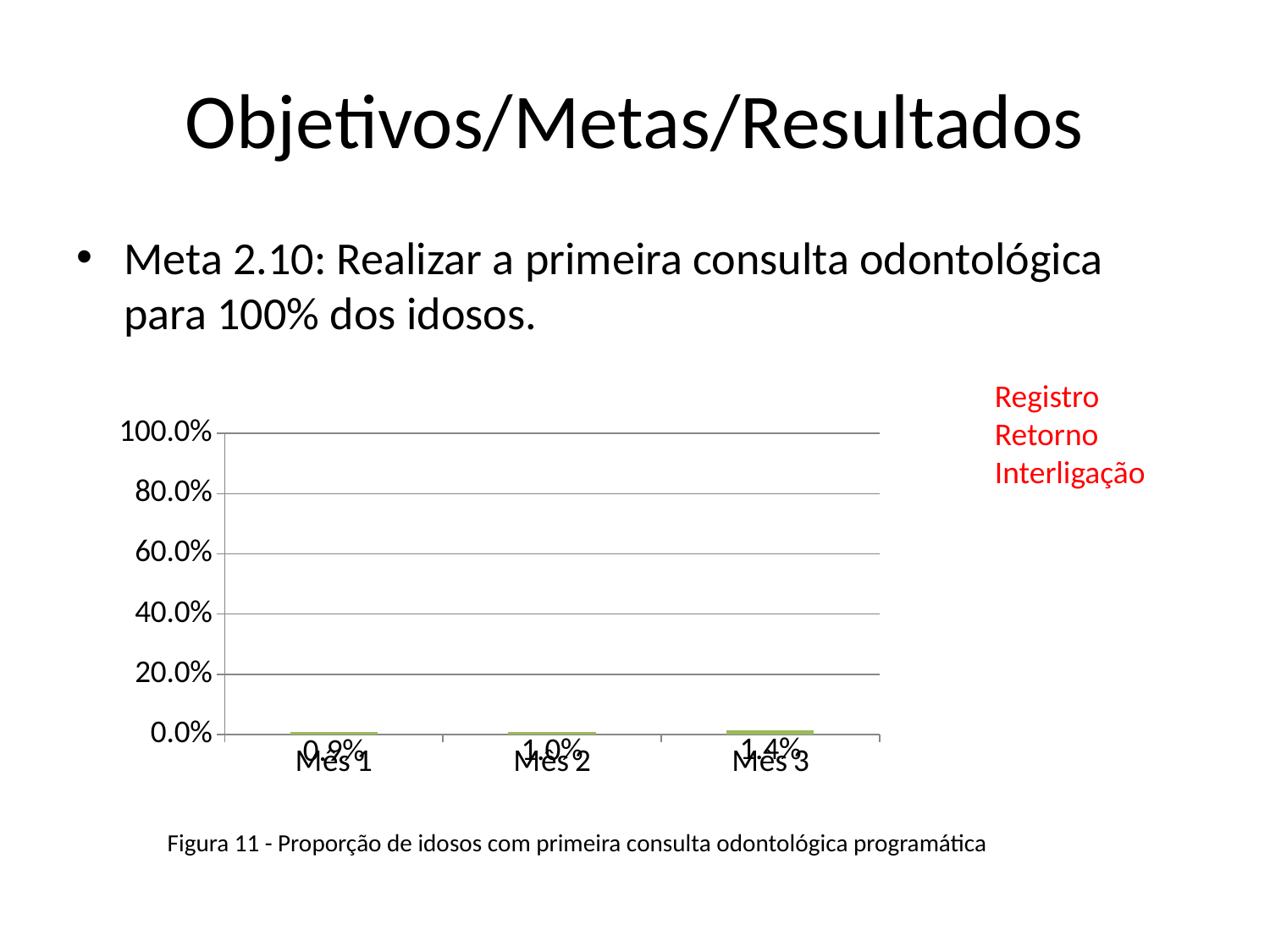
What is the difference between the values for Mês 3 and Mês 2? 0.4% Which is larger, the value for Mês 2 or the value for Mês 1? Mês 2 Do the values rise or fall from Mês 1 to Mês 3? rise What is the value for Mês 1? 0.9% Is the value for Mês 3 greater or less than 20.0%? less Which month has the highest value? Mês 3 How many months are shown on the x axis? 3 What is the value for Mês 3? 1.4% Which month has the lowest value? Mês 1 What is the value for Mês 2? 1.0% What is the difference between the values for Mês 3 and Mês 1? 0.5% What kind of chart is shown on the slide? bar chart